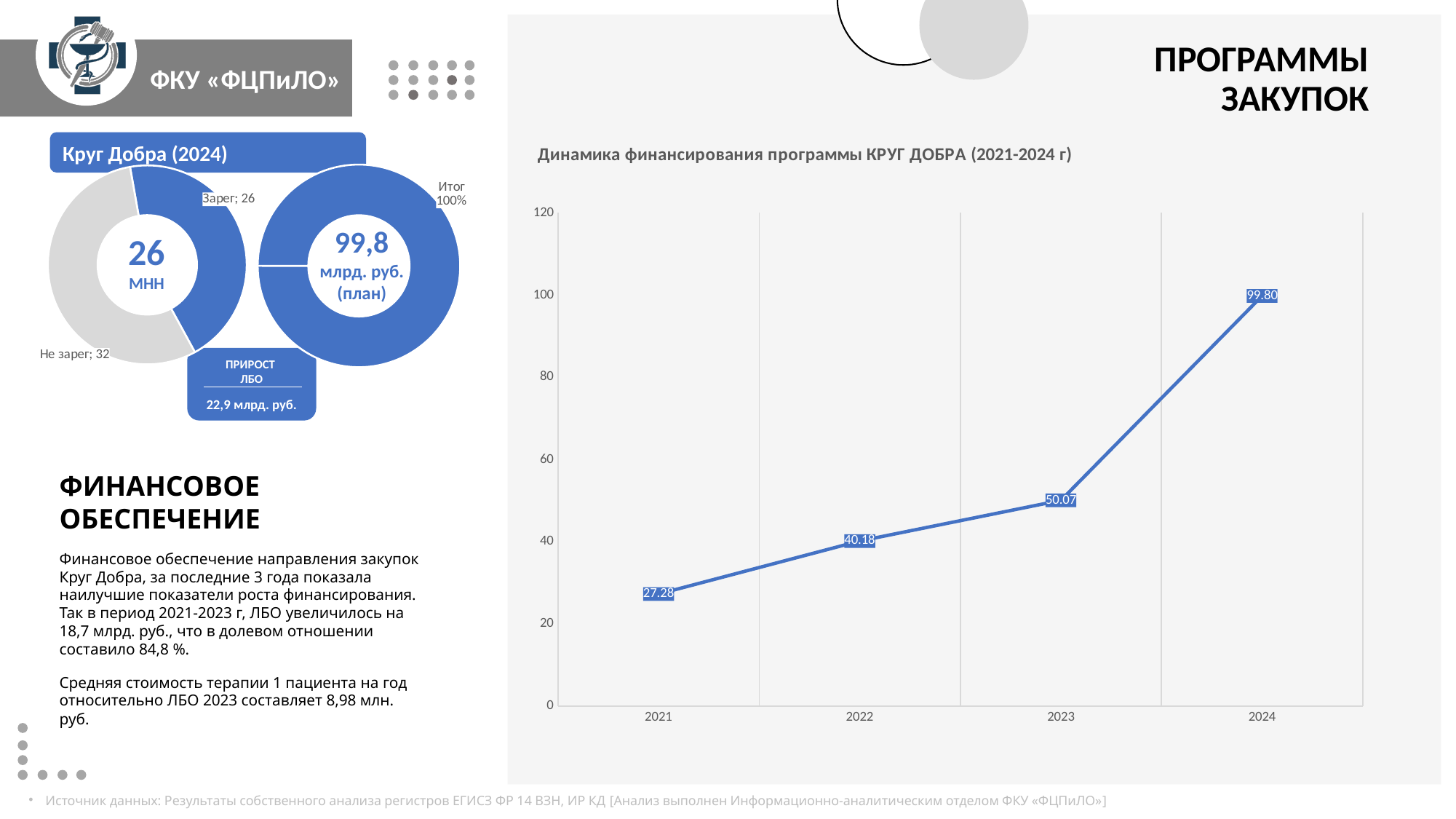
What kind of chart is 'Динамика финансирования программы КРУГ ДОБРА (2021-2024 г)'? line chart In the line chart 'Динамика финансирования программы КРУГ ДОБРА (2021-2024 г)', what is the difference between the 2024 and 2023 values? 49.73 In the line chart 'Динамика финансирования программы КРУГ ДОБРА (2021-2024 г)', what is the value for 2023? 50.07 In the line chart 'Динамика финансирования программы КРУГ ДОБРА (2021-2024 г)', do the values rise or fall from 2021 to 2024? rise What number is shown in the centre of the right donut chart under 'Круг Добра (2024)'? 99,8 млрд. руб. (план) In the line chart 'Динамика финансирования программы КРУГ ДОБРА (2021-2024 г)', is the value for 2022 greater or less than 40? greater In the line chart 'Динамика финансирования программы КРУГ ДОБРА (2021-2024 г)', which year has the highest value? 2024 In the line chart 'Динамика финансирования программы КРУГ ДОБРА (2021-2024 г)', how many years are plotted? 4 In the left donut chart under 'Круг Добра (2024)', which slice is larger, 'Зарег' or 'Не зарег'? Не зарег In the left donut chart under 'Круг Добра (2024)', what is the value for 'Не зарег'? 32 In the line chart 'Динамика финансирования программы КРУГ ДОБРА (2021-2024 г)', what is the value for 2021? 27.28 In the line chart 'Динамика финансирования программы КРУГ ДОБРА (2021-2024 г)', which year has the lowest value? 2021